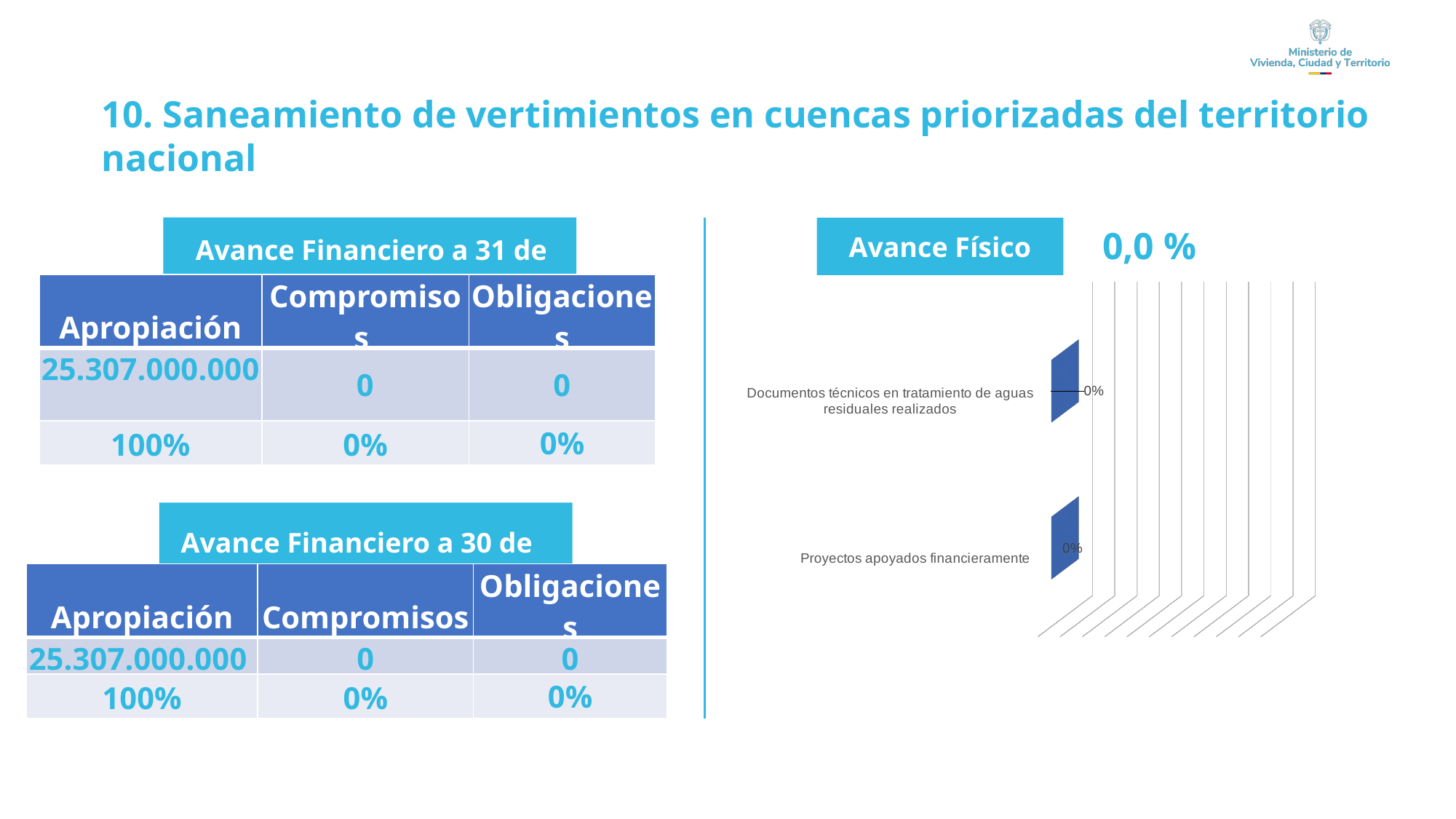
What is the value for 'Proyectos apoyados financieramente' in the Avance Físico chart? 0% What is the value for 'Documentos técnicos en tratamiento de aguas residuales realizados' in the Avance Físico chart? 0% What kind of chart is the Avance Físico chart? bar chart What is the difference between the values for 'Documentos técnicos en tratamiento de aguas residuales realizados' and 'Proyectos apoyados financieramente' in the Avance Físico chart? 0% What overall percentage is shown next to the Avance Físico chart title? 0,0 % What is the title of the chart on the right side of the slide? Avance Físico How many categories are plotted in the Avance Físico chart? 2